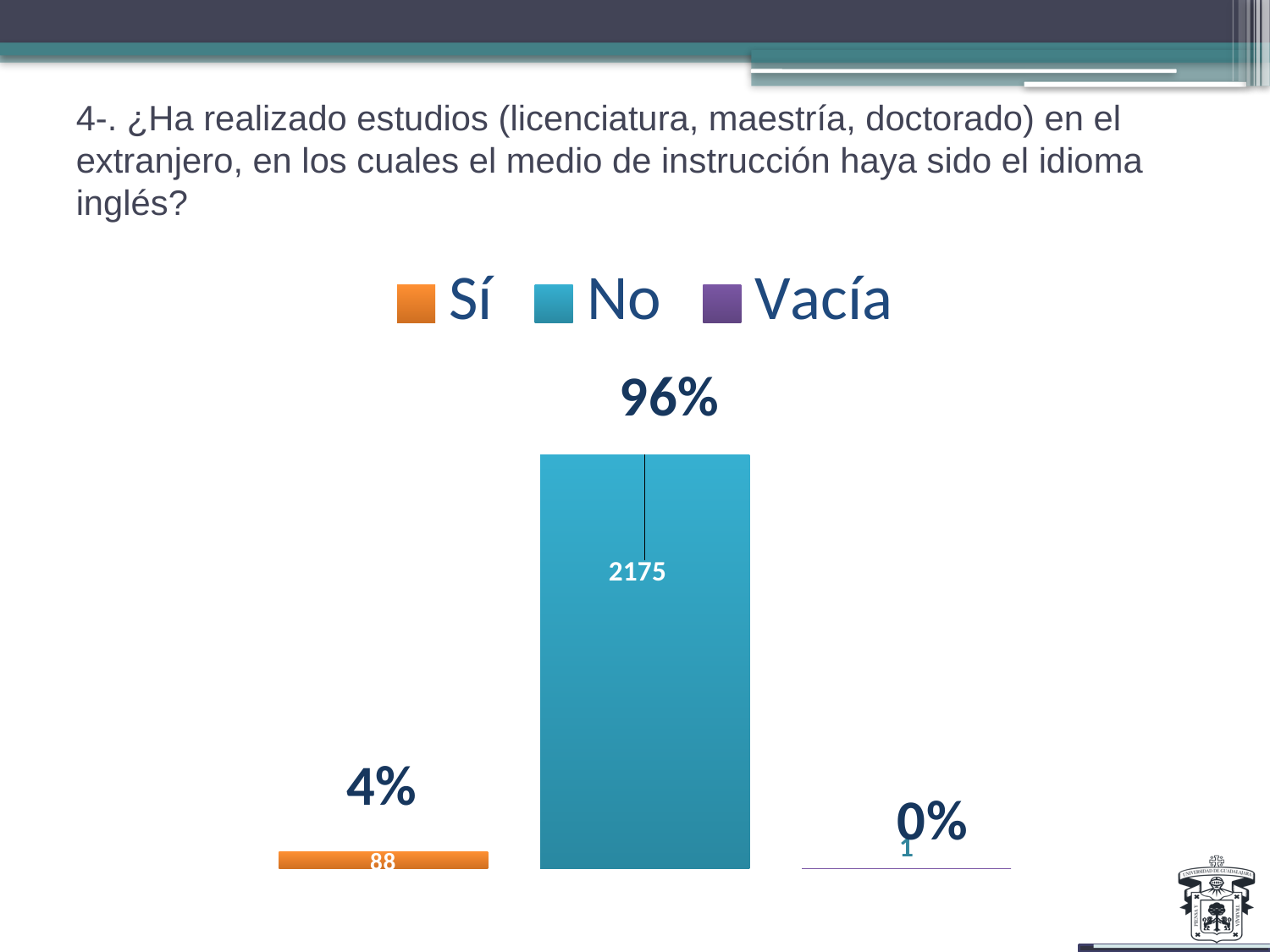
Which category has the lowest value? Vacía Which category has the highest value? No What is the count shown for the "Sí" bar? 88 What percentage is shown above the "Sí" bar? 4% What is the difference between the counts for "No" and "Sí"? 2087 What colour is the "Sí" bar? orange How many series does the legend list? 3 What percentage is shown for "Vacía"? 0% Which is larger, the value for "Sí" or the value for "No"? No What is the count shown for the "No" bar? 2175 What kind of chart is shown on the slide? bar chart What percentage is shown above the "No" bar? 96%